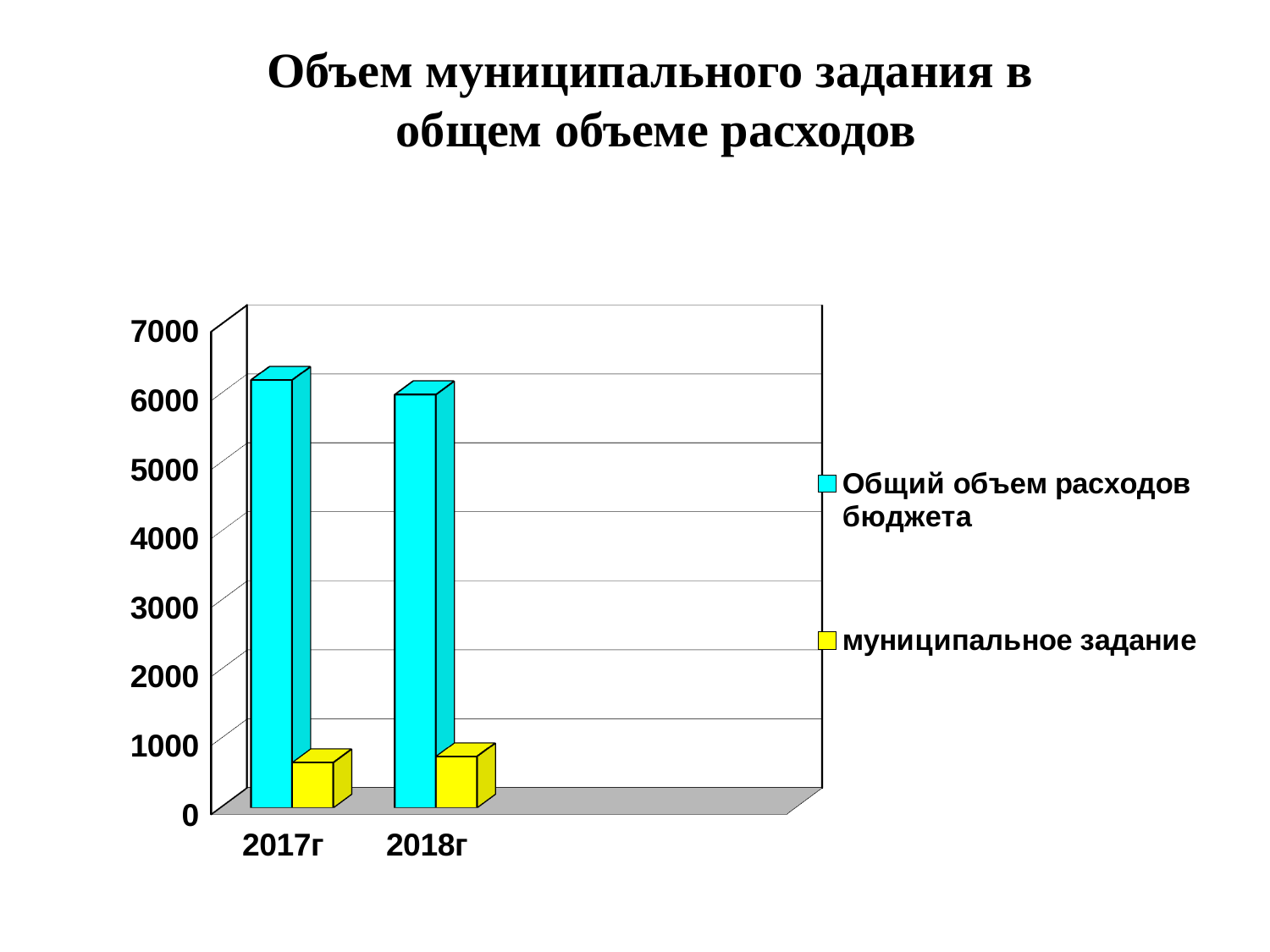
How many series does the legend list? 2 What kind of chart is shown on the slide? bar chart Is the value for муниципальное задание in 2018г greater or less than 1000? less In 2017г, which is larger: Общий объем расходов бюджета or муниципальное задание? Общий объем расходов бюджета What is the title of the chart? Объем муниципального задания в общем объеме расходов In which year is Общий объем расходов бюджета highest? 2017г Does Общий объем расходов бюджета rise or fall from 2017г to 2018г? fall Which series is shown in yellow according to the legend? муниципальное задание Is the value for Общий объем расходов бюджета in 2018г greater or less than 5000? greater Is the value for Общий объем расходов бюджета in 2017г greater or less than 5000? greater How many years (categories) are shown on the x axis? 2